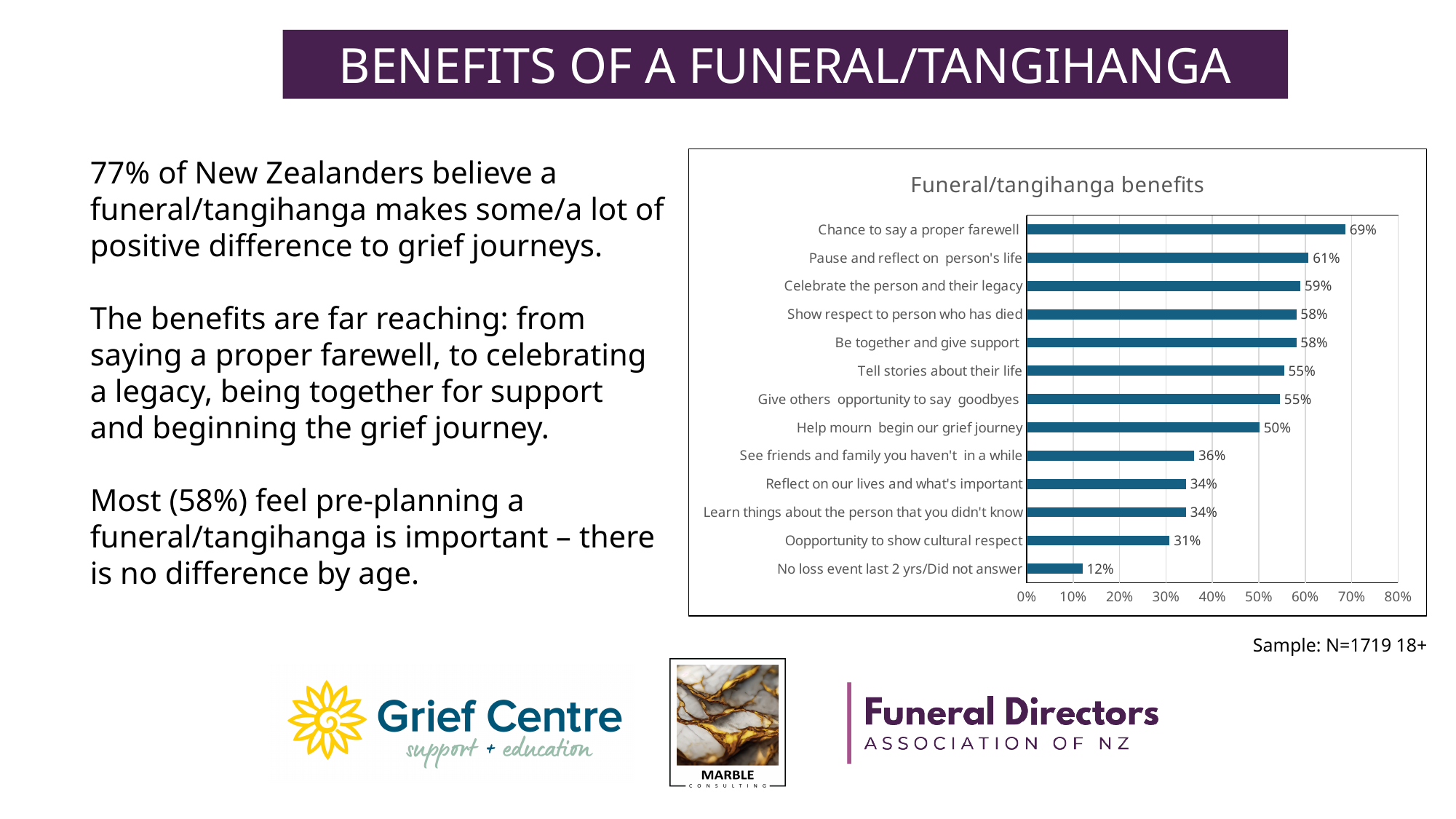
What is the title of the chart? Funeral/tangihanga benefits Is the value for "Reflect on our lives and what's important" greater or less than 40%? less What kind of chart is shown on the slide? Bar chart How many categories are shown in the chart? 13 Which is larger: "Celebrate the person and their legacy" or "Tell stories about their life"? Celebrate the person and their legacy What is the value for "Chance to say a proper farewell"? 69% Which category has the highest value? Chance to say a proper farewell What is the value for "Oopportunity to show cultural respect"? 31% Which category has the lowest value? No loss event last 2 yrs/Did not answer What is the value for "Help mourn begin our grief journey"? 50% What is the difference between "Chance to say a proper farewell" and "Pause and reflect on person's life"? 8% What is the difference between "See friends and family you haven't in a while" and "No loss event last 2 yrs/Did not answer"? 24%